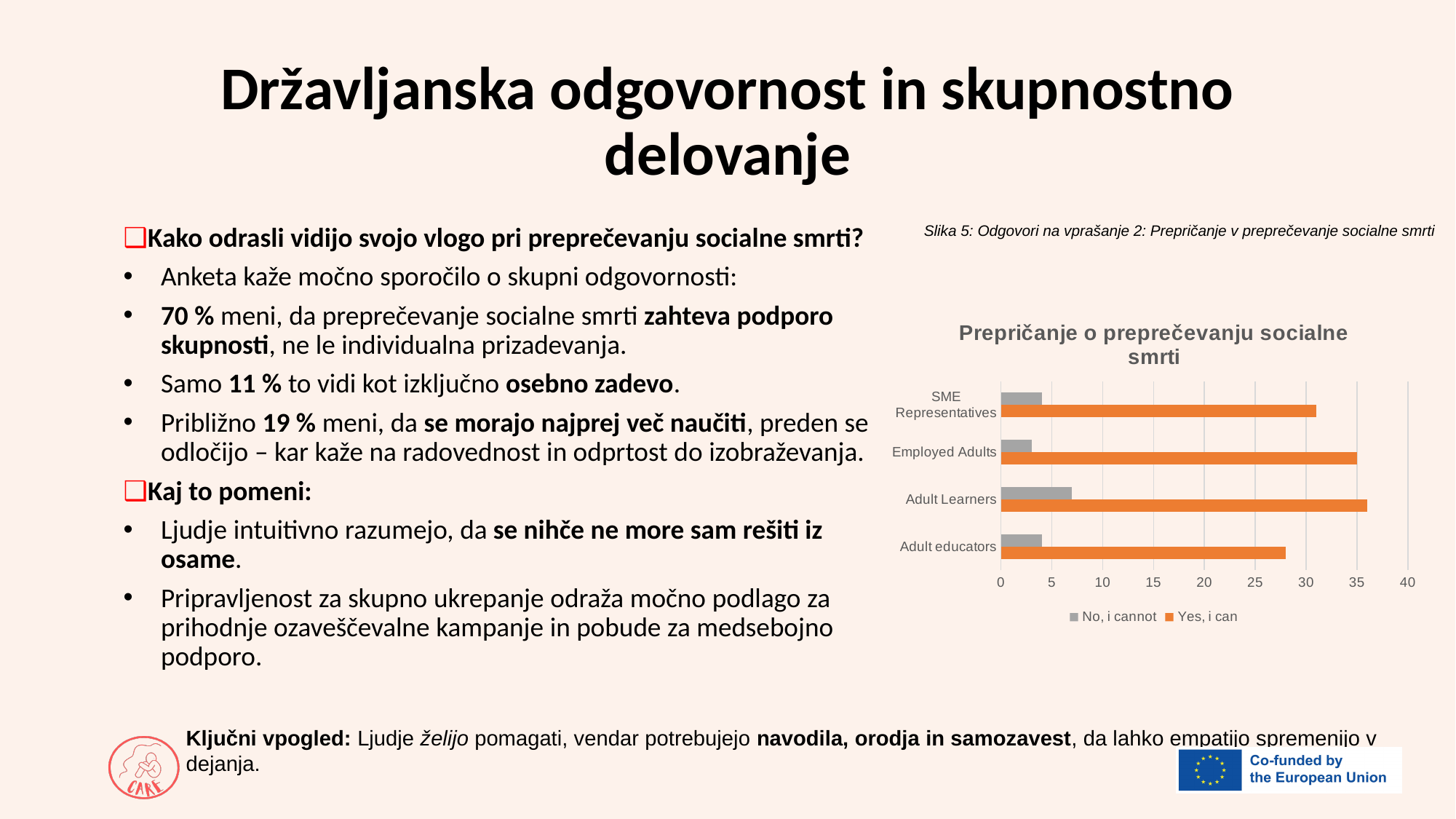
What kind of chart is shown on the slide? bar chart Is the 'No, i cannot' value for Adult Learners greater or less than 10? less Which category has the highest value for the 'No, i cannot' series? Adult Learners How many categories are shown on the chart's vertical axis? 4 Is the 'Yes, i can' value for Employed Adults greater or less than 30? greater For SME Representatives, which series has the larger value, 'Yes, i can' or 'No, i cannot'? Yes, i can Is the 'Yes, i can' value for Adult educators greater or less than 30? less Which series is shown in orange in the chart? Yes, i can What is the title of the chart? Prepričanje o preprečevanju socialne smrti Which category has the lowest value for the 'Yes, i can' series? Adult educators How many series does the chart's legend list? 2 Which is larger: the 'No, i cannot' value for Adult Learners or for Employed Adults? Adult Learners